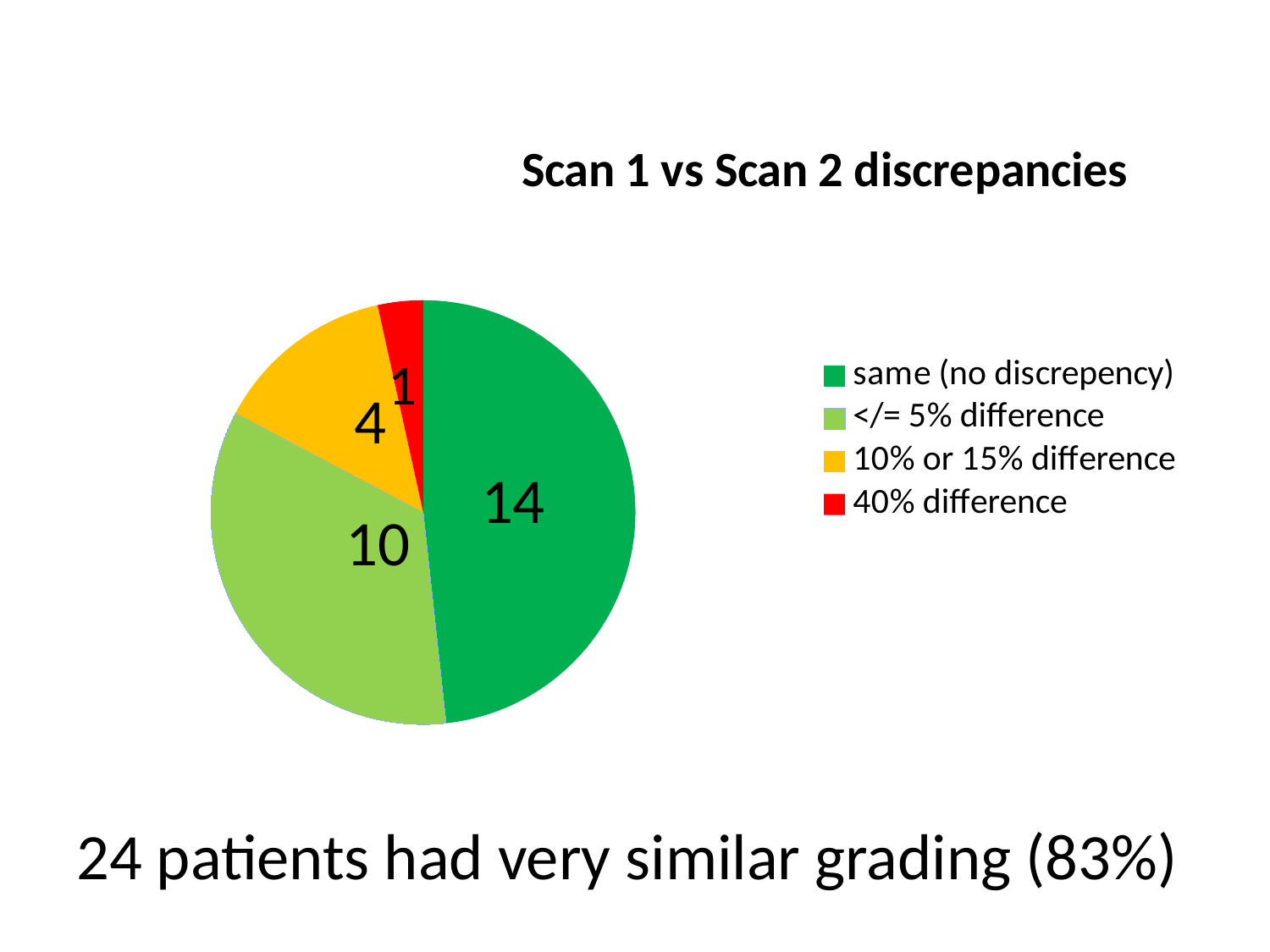
What is the difference between the 'same (no discrepency)' slice and the '</= 5% difference' slice? 4 What is the title of the pie chart? Scan 1 vs Scan 2 discrepancies Which category has the smallest slice of the pie? 40% difference Which category has the largest slice of the pie? same (no discrepency) What type of chart is shown on the slide? pie chart What is the value of the '40% difference' slice? 1 How many patients are in the 'same (no discrepency)' slice? 14 What is the value of the '10% or 15% difference' slice? 4 How many categories does the legend list? 4 What is the total of all the slices in the pie chart? 29 Which is larger: the '10% or 15% difference' slice or the '40% difference' slice? 10% or 15% difference What is the value of the '</= 5% difference' slice? 10